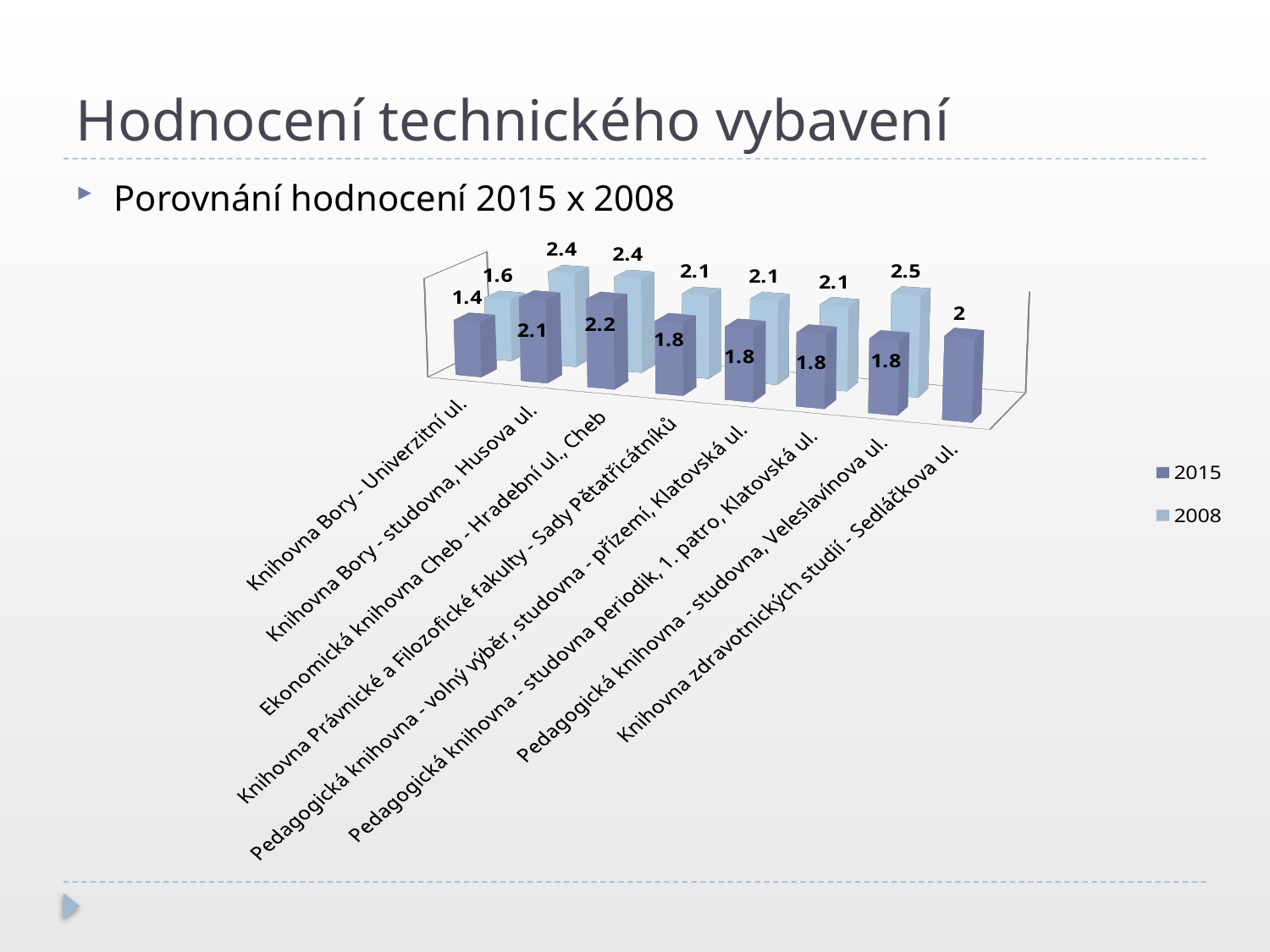
What kind of chart is shown on the slide? Bar chart What is the 2015 value for Knihovna zdravotnických studií - Sedláčkova ul.? 2 What is the 2015 value for Ekonomická knihovna Cheb - Hradební ul., Cheb? 2.2 What is the 2008 value for Pedagogická knihovna - studovna, Veleslavínova ul.? 2.5 Which category has the highest 2008 value? Pedagogická knihovna - studovna, Veleslavínova ul. What is the difference between the 2008 and 2015 values for Pedagogická knihovna - studovna, Veleslavínova ul.? 0.7 How many categories are shown on the x axis of the chart? 8 What is the 2015 value for Knihovna Bory - Univerzitní ul.? 1.4 How many series does the legend list? 2 For Knihovna Právnické a Filozofické fakulty - Sady Pětatřicátníků, which is larger: the 2015 value or the 2008 value? 2008 What is the difference between the 2008 and 2015 values for Knihovna Bory - studovna, Husova ul.? 0.3 Which category has the lowest 2015 value? Knihovna Bory - Univerzitní ul.